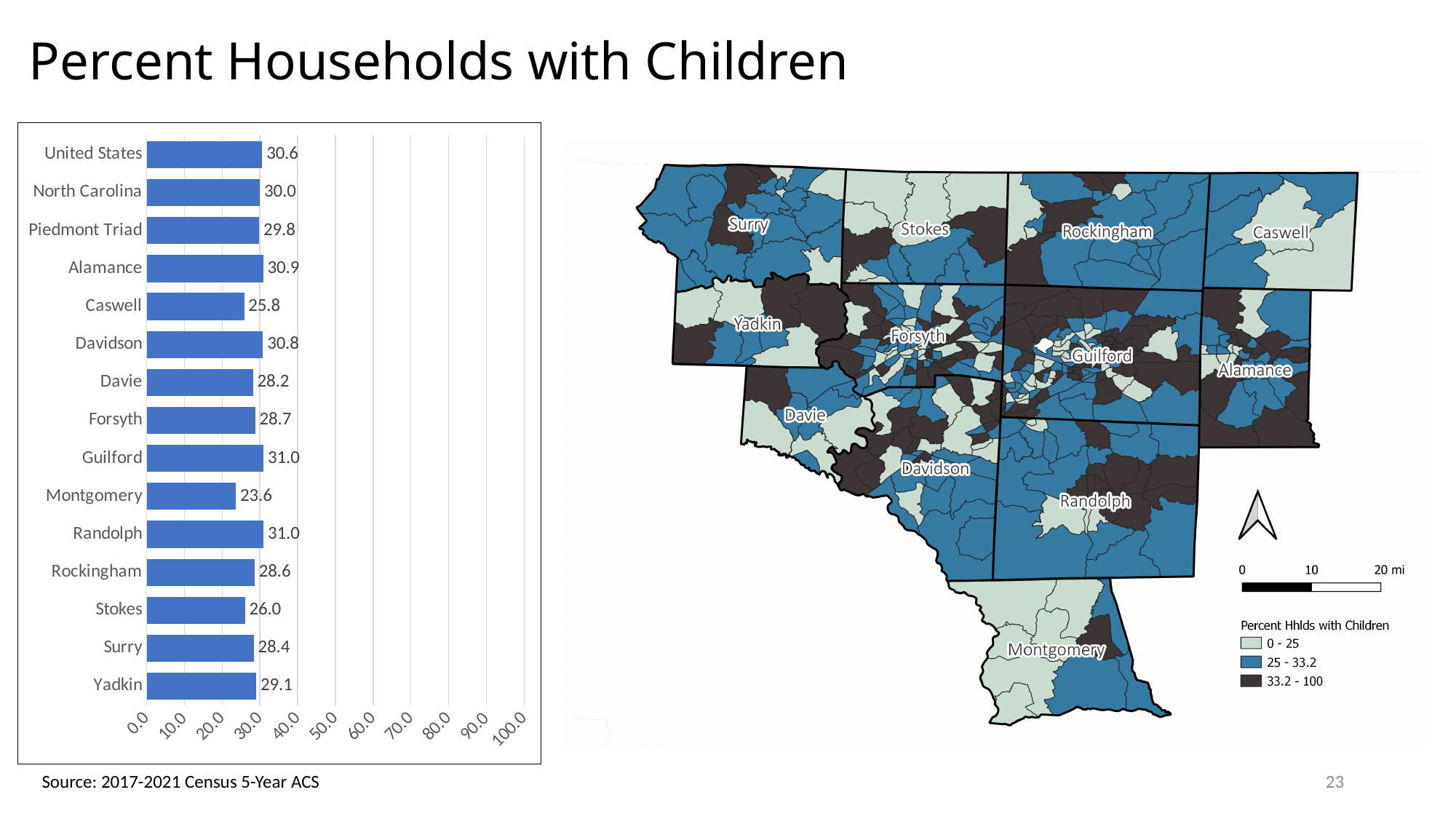
In the bar chart, what is the value for North Carolina? 30.0 What is the source cited below the bar chart? 2017-2021 Census 5-Year ACS In the bar chart, what is the value for Montgomery? 23.6 In the bar chart, what is the value for Alamance? 30.9 How many categories are shown in the bar chart? 15 In the bar chart, what is the difference between the values for United States and Montgomery? 7.0 In the bar chart, what is the difference between the values for Alamance and Caswell? 5.1 In the bar chart, is the value for Stokes greater or less than 30.0? less What kind of chart is shown on the left of the slide? bar chart In the bar chart, what is the value for Yadkin? 29.1 In the bar chart, which is larger, the value for Davidson or the value for Davie? Davidson In the bar chart, which category has the lowest value? Montgomery